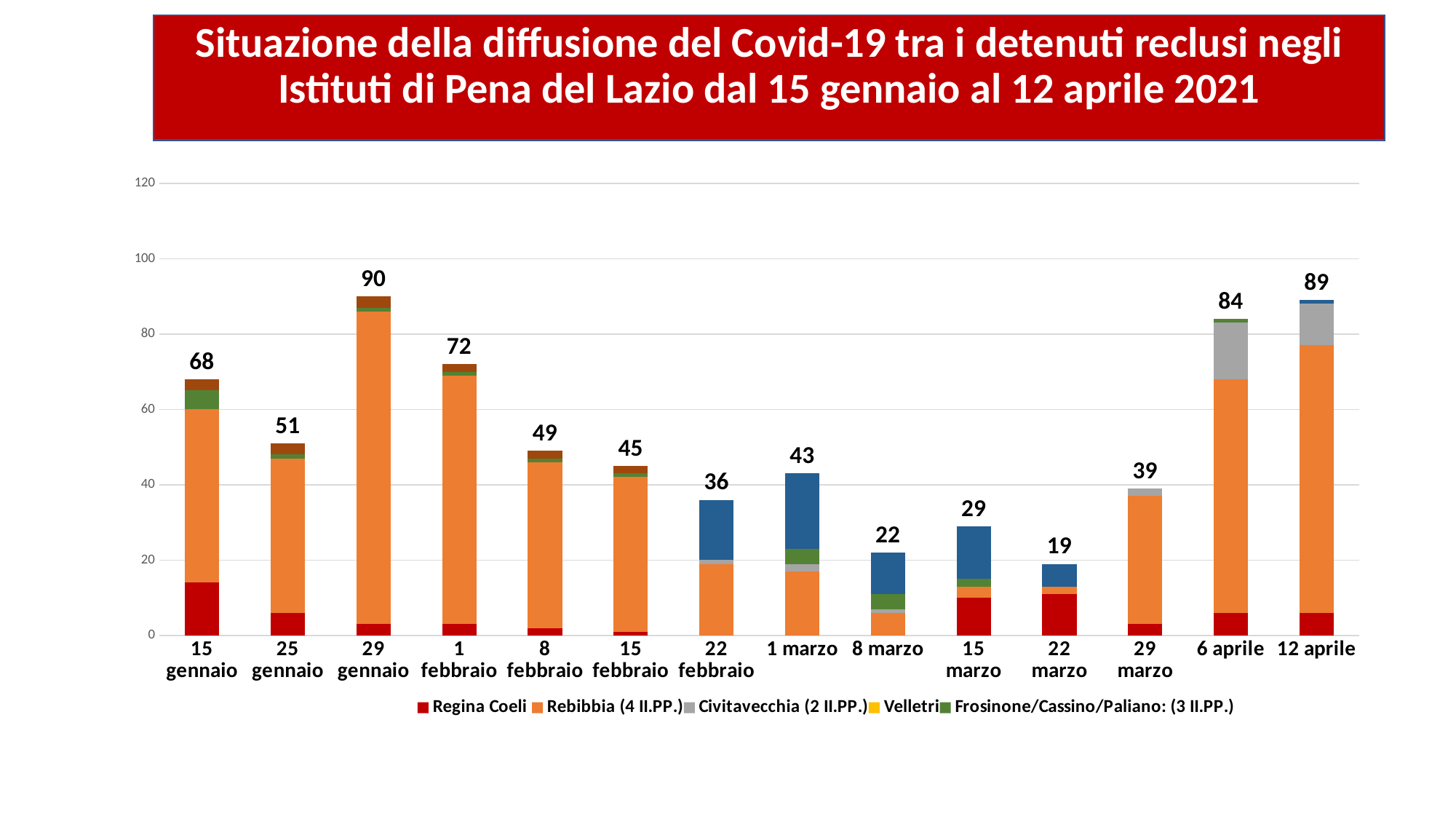
Do the totals rise or fall from 29 gennaio to 22 marzo? Fall What is the difference between the totals for 12 aprile and 6 aprile? 5 Which date has the highest total? 29 gennaio What is the difference between the totals for 29 gennaio and 22 marzo? 71 What kind of chart is shown on the slide? Stacked bar chart Is the Regina Coeli value on 15 gennaio greater or less than 20? less How many series does the legend list? 5 What is the total value shown for the bar on 29 gennaio? 90 Which date has the lowest total? 22 marzo What is the total value shown for the bar on 8 marzo? 22 How many dates are shown on the x axis? 14 Which total is larger, 15 gennaio or 1 febbraio? 1 febbraio